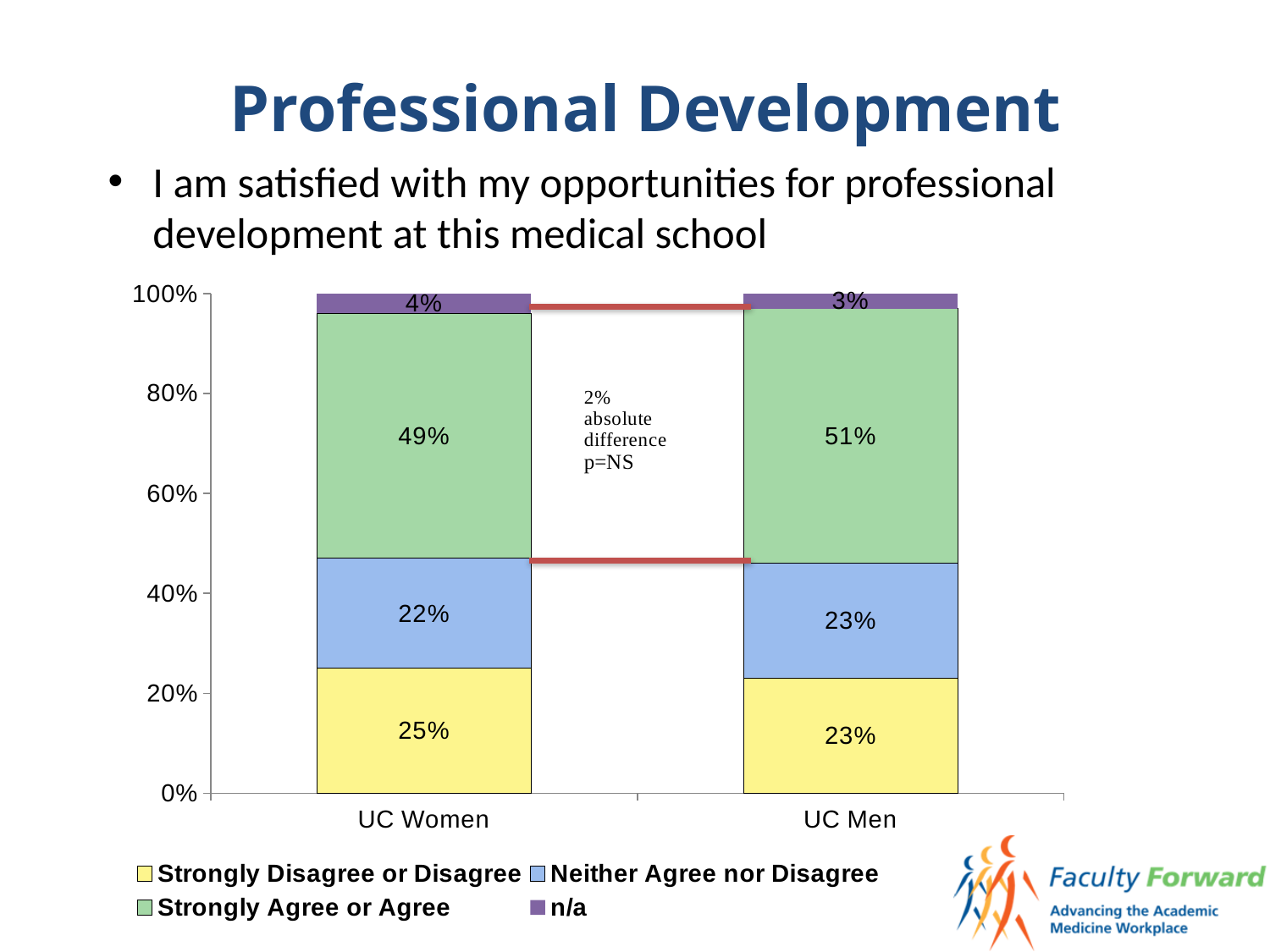
What percentage of UC Women responded 'Strongly Disagree or Disagree'? 25% Which response category is the largest for UC Men? Strongly Agree or Agree What percentage of UC Women responded 'Strongly Agree or Agree'? 49% Which group has the larger 'Strongly Disagree or Disagree' share, UC Women or UC Men? UC Women What kind of chart is shown on the slide? Stacked bar chart What percentage of UC Men responded 'Strongly Agree or Agree'? 51% What is the difference between the 'Strongly Agree or Agree' percentages for UC Men and UC Women? 2% How many groups are shown on the x axis? 2 How many series does the legend list? 4 What is the 'n/a' percentage for UC Women? 4% What percentage of UC Men responded 'Neither Agree nor Disagree'? 23% Which response category is the smallest for UC Women? n/a